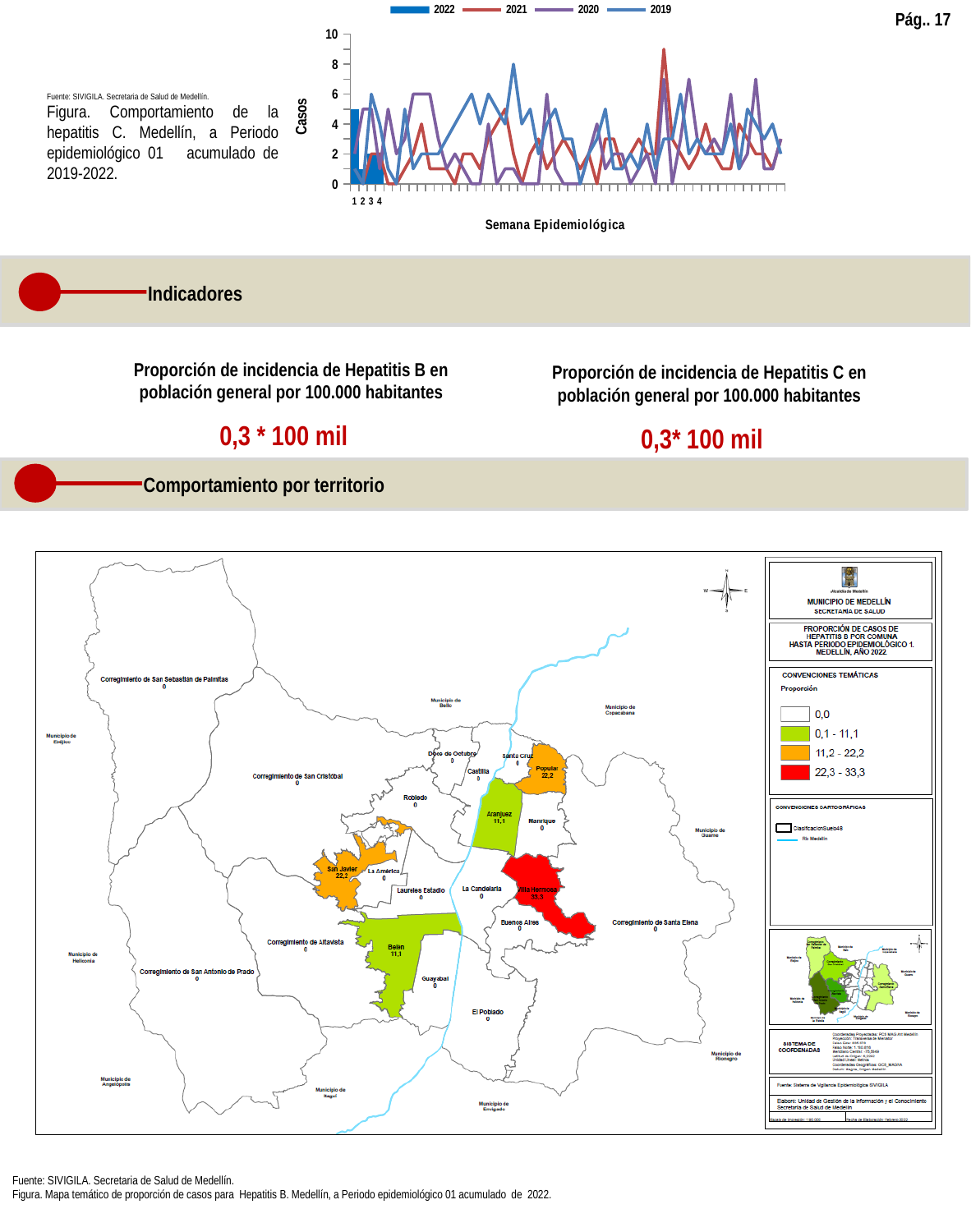
What kind of chart is the top chart on the slide (Comportamiento de la hepatitis C)? Combination bar and line chart (2022 drawn as bars, the other years as lines) In the top line chart, which series reaches the highest single peak? 2021 In the top line chart, is the 2022 value for week 1 greater or less than 4? greater How many series does the legend of the top line chart list? 4 On the map of Hepatitis B proportion by comuna, which comuna has the highest proportion? Villa Hermosa In the top line chart, is the highest value of the 2021 series greater or less than 8? greater Which years are listed in the legend of the top line chart? 2022, 2021, 2020, 2019 What is the label of the vertical axis of the top line chart? Casos On the map of Hepatitis B proportion by comuna, what is the value shown for Villa Hermosa? 33,3 On the map of Hepatitis B proportion by comuna, what is the value shown for Belén? 11,1 How many epidemiological weeks are plotted for the 2022 series in the top line chart? 4 On the map of Hepatitis B proportion by comuna, what is the difference between the values for Popular and Aranjuez? 11,1